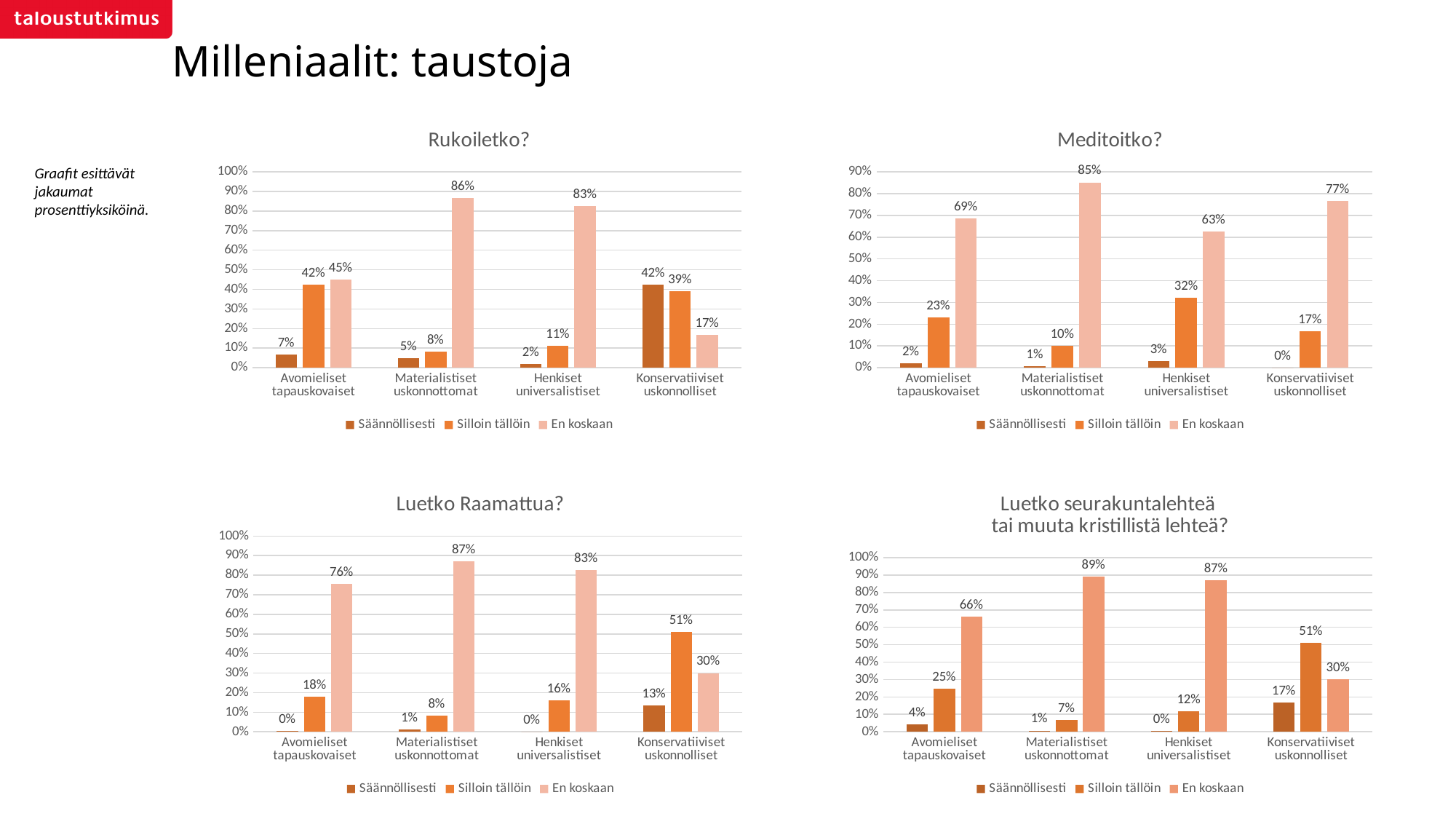
In the "Rukoiletko?" chart, what is the value of "Säännöllisesti" for Konservatiiviset uskonnolliset? 42% In the "Luetko Raamattua?" chart, which category has the lowest "En koskaan" value? Konservatiiviset uskonnolliset In the "Rukoiletko?" chart, what is the value of "En koskaan" for Materialistiset uskonnottomat? 86% How many series does the legend of the "Meditoitko?" chart list? 3 In the "Luetko Raamattua?" chart, what is the difference between the "Silloin tällöin" and "En koskaan" values for Konservatiiviset uskonnolliset? 21% In the "Meditoitko?" chart, what is the value of "Silloin tällöin" for Henkiset universalistiset? 32% What type of chart is "Luetko Raamattua?"? bar chart In the "Luetko seurakuntalehteä tai muuta kristillistä lehteä?" chart, what is the value of "En koskaan" for Avomieliset tapauskovaiset? 66% How many categories are shown on the x axis of the "Rukoiletko?" chart? 4 In the "Rukoiletko?" chart, is the "En koskaan" value for Henkiset universalistiset greater or less than 80%? greater In the "Luetko seurakuntalehteä tai muuta kristillistä lehteä?" chart, is the "En koskaan" value for Materialistiset uskonnottomat greater or less than the "En koskaan" value for Henkiset universalistiset? greater In the "Meditoitko?" chart, which category has the highest "En koskaan" value? Materialistiset uskonnottomat